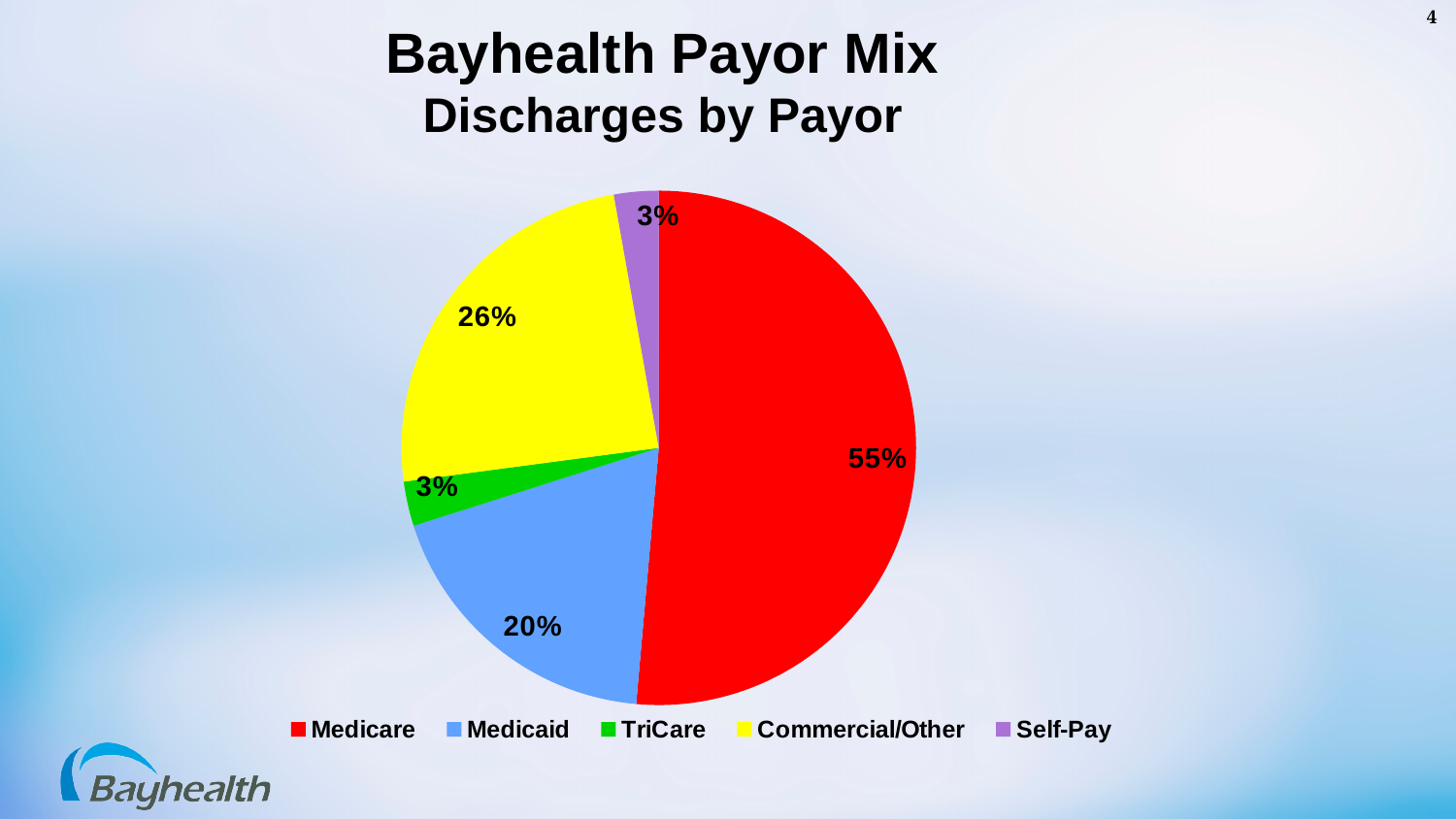
What kind of chart is shown on the slide? Pie chart What is the difference between the Medicare and Medicaid shares? 35% What is the subtitle of the chart? Discharges by Payor Which is larger, the Commercial/Other share or the Medicaid share? Commercial/Other How many payor categories does the pie chart show? 5 What share of discharges is Commercial/Other? 26% Which payor has the largest share of discharges? Medicare What share of discharges is Medicaid? 20% What share of discharges is TriCare? 3% What is the difference between the Commercial/Other and Medicaid shares? 6% What colour represents Self-Pay in the pie chart? Purple What share of discharges is Medicare? 55%